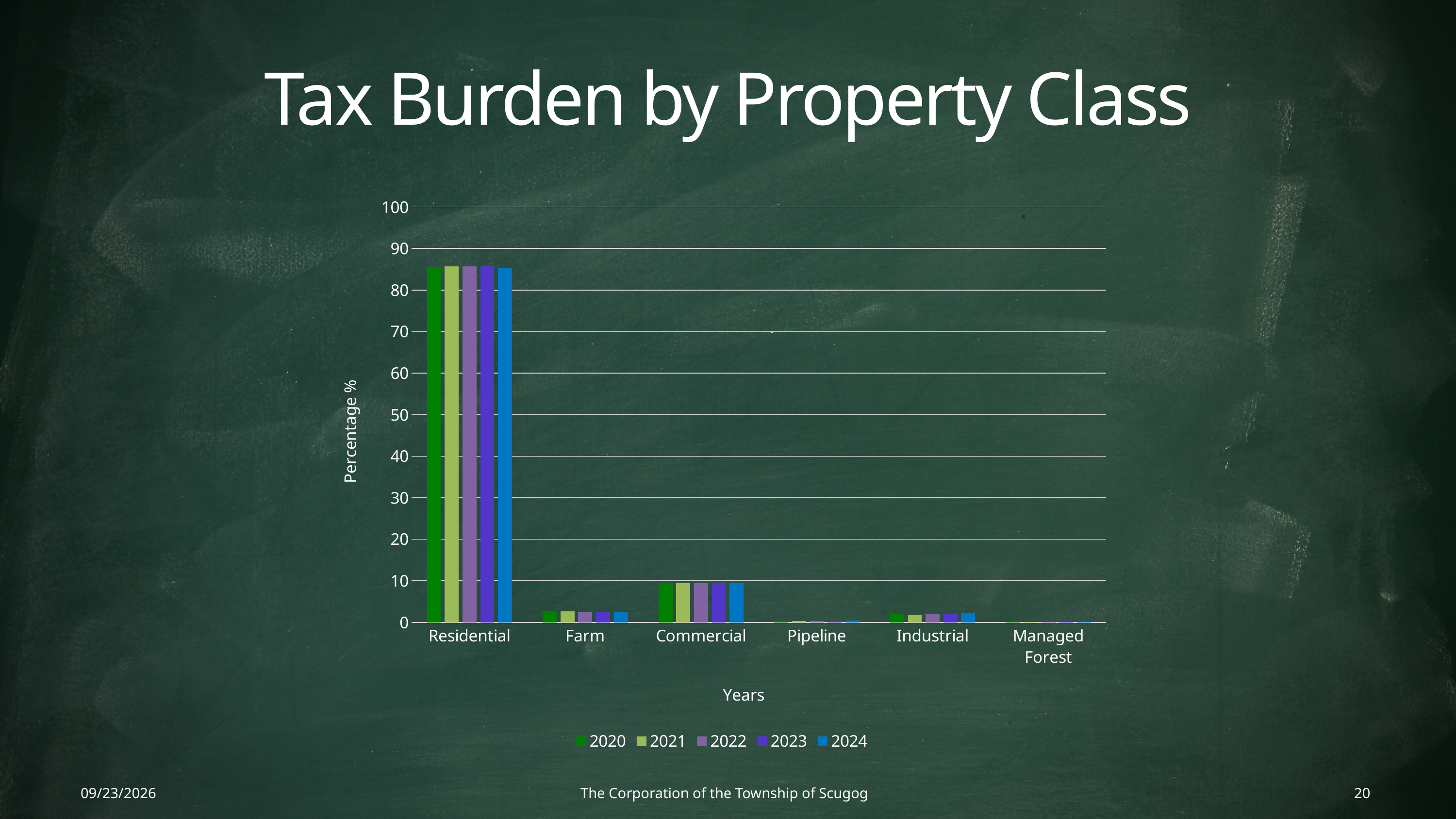
What is the label on the vertical axis? Percentage % Is the value for Farm in 2021 greater or less than 10? less Is the value for Residential in 2020 greater or less than 80? greater What is the title of the chart? Tax Burden by Property Class What kind of chart is shown on the slide? Bar chart Is the value for Commercial in 2024 greater or less than 20? less Which has a larger value in 2024, Industrial or Residential? Residential Which property class has the highest tax burden percentage? Residential Which has a larger value in 2022, Commercial or Farm? Commercial How many series does the legend list? 5 How many property class categories are shown on the x axis? 6